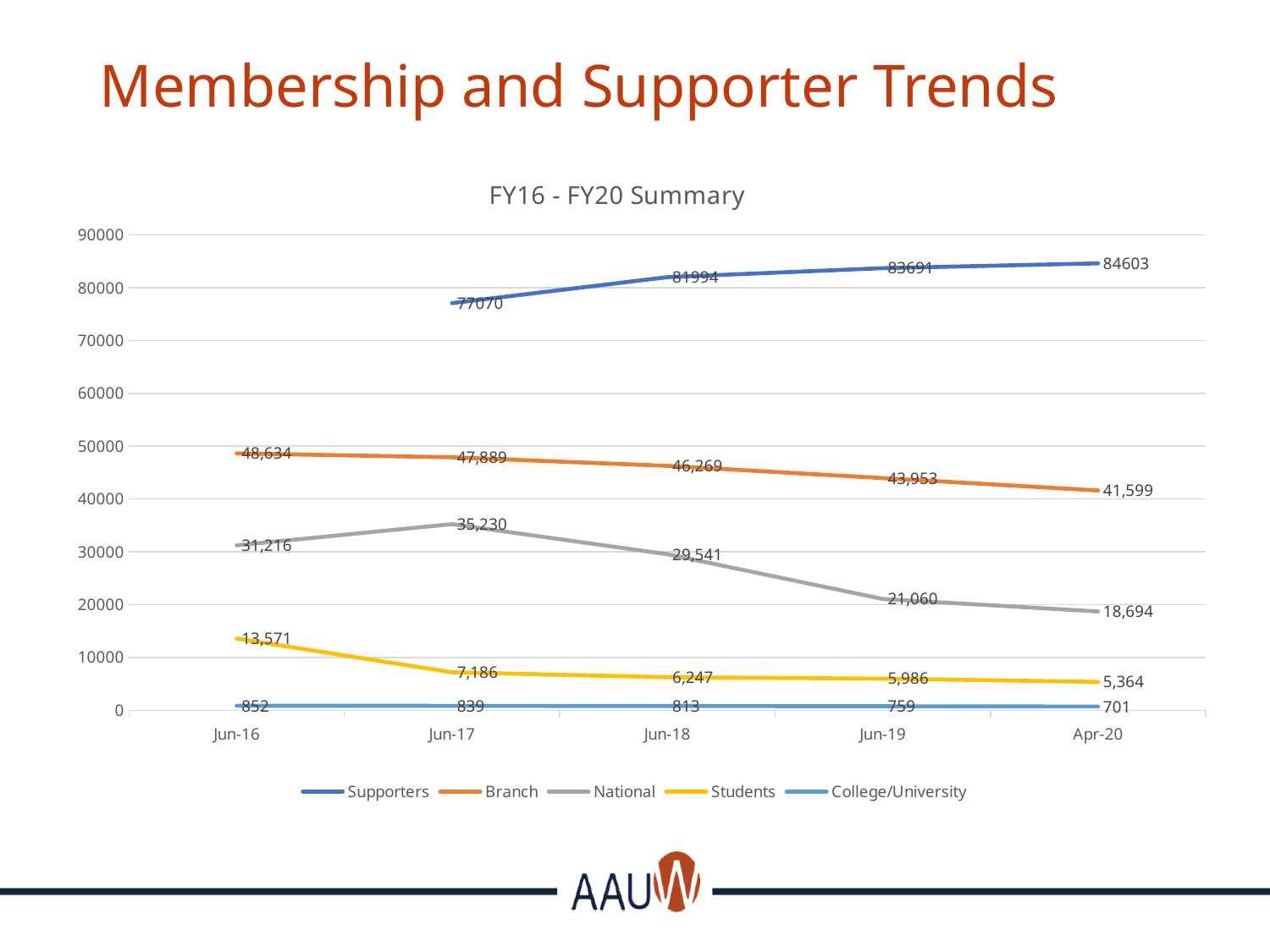
What kind of chart is shown on the slide? Line chart What is the difference between the Branch values at Jun-16 and Apr-20? 7,035 What is the value for College/University at Jun-19? 759 Which is larger at Jun-18: the Branch value or the National value? Branch What is the value for Branch at Jun-16? 48,634 What is the title of the chart? FY16 - FY20 Summary At which x-axis point is the Students series lowest? Apr-20 At which x-axis point is the National series highest? Jun-17 What is the value for National at Jun-17? 35,230 How many series does the legend list? 5 What is the value for Supporters at Apr-20? 84603 Do the Supporters values rise or fall from Jun-17 to Apr-20? Rise